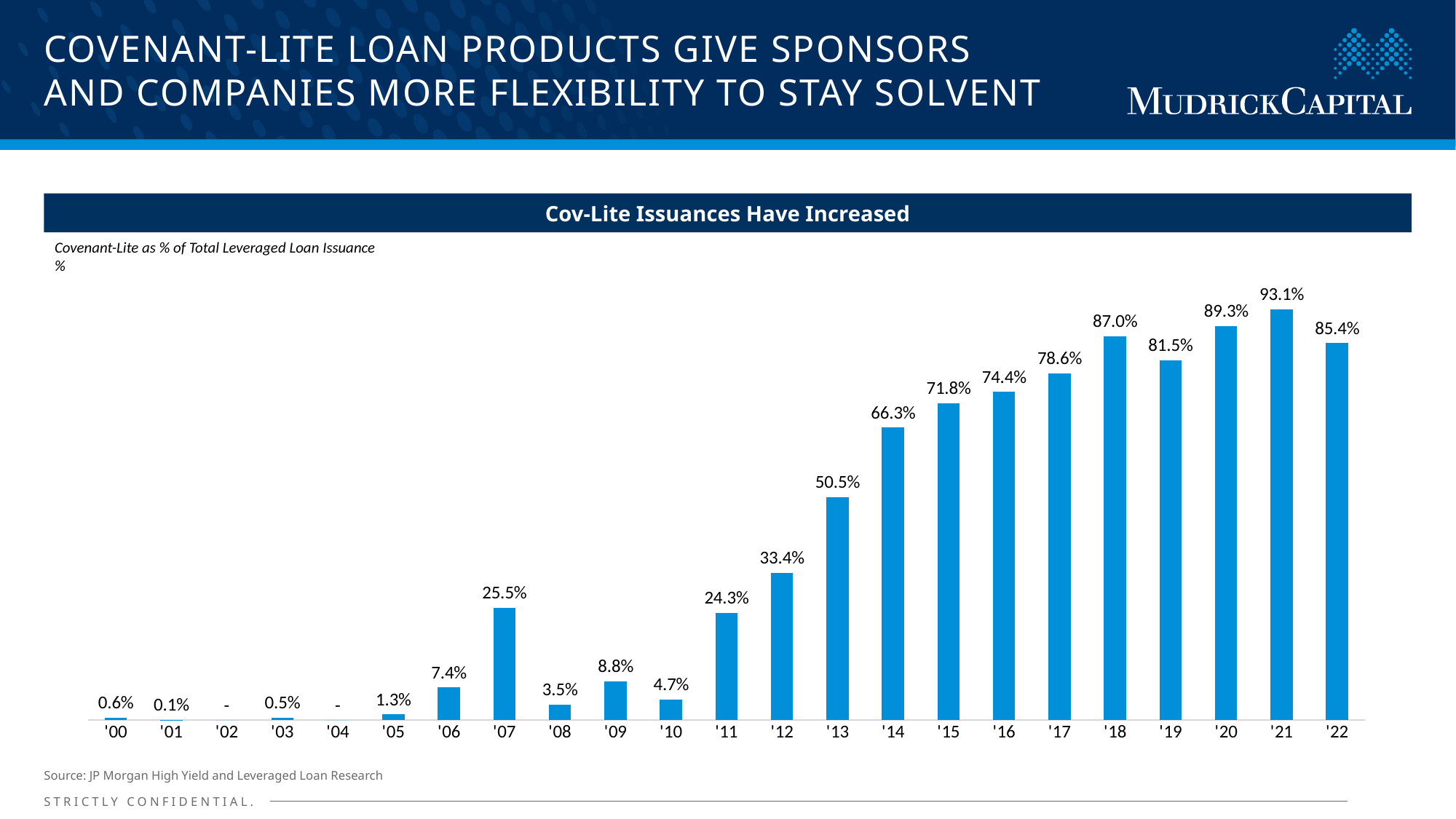
Do the values generally rise or fall from '10 to '21? Rise What is the title of the chart? Cov-Lite Issuances Have Increased What is the source cited for the chart? JP Morgan High Yield and Leveraged Loan Research What is the value for '07? 25.5% What is the difference between the values for '21 and '22? 7.7% Which is larger, the value for '18 or the value for '19? '18 What kind of chart is this? Bar chart How many years are shown on the x axis? 23 What is the covenant-lite share of total leveraged loan issuance in '21? 93.1% What value is shown for '13? 50.5% Which year has the highest covenant-lite share? '21 Which year has the lowest labelled non-zero value? '01